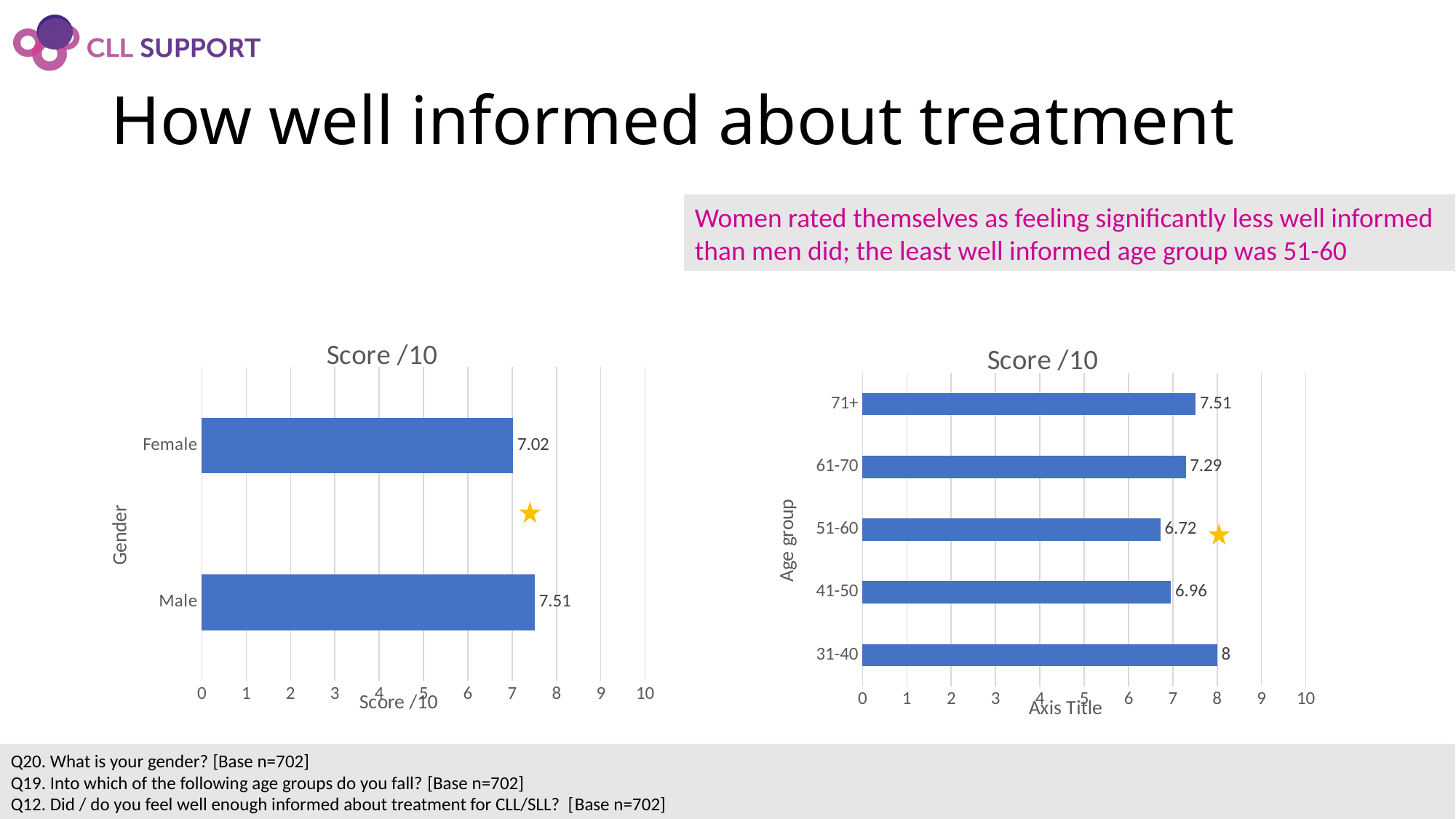
In the left chart (Gender), which category has the higher score, Female or Male? Male In the left chart (Gender), what is the score for Female? 7.02 In the right chart (Age group), is the score for 41-50 greater or less than 7? less In the left chart (Gender), what is the score for Male? 7.51 In the right chart (Age group), which age group has the lowest score? 51-60 In the left chart (Gender), what is the difference between the Male and Female scores? 0.49 In the right chart (Age group), what is the score for the 51-60 age group? 6.72 What type of chart is the left chart (Gender)? Bar chart In the right chart (Age group), what is the score for the 31-40 age group? 8 In the right chart (Age group), how many age groups are shown? 5 In the right chart (Age group), what is the difference between the scores for 71+ and 61-70? 0.22 In the right chart (Age group), which age group has the highest score? 31-40